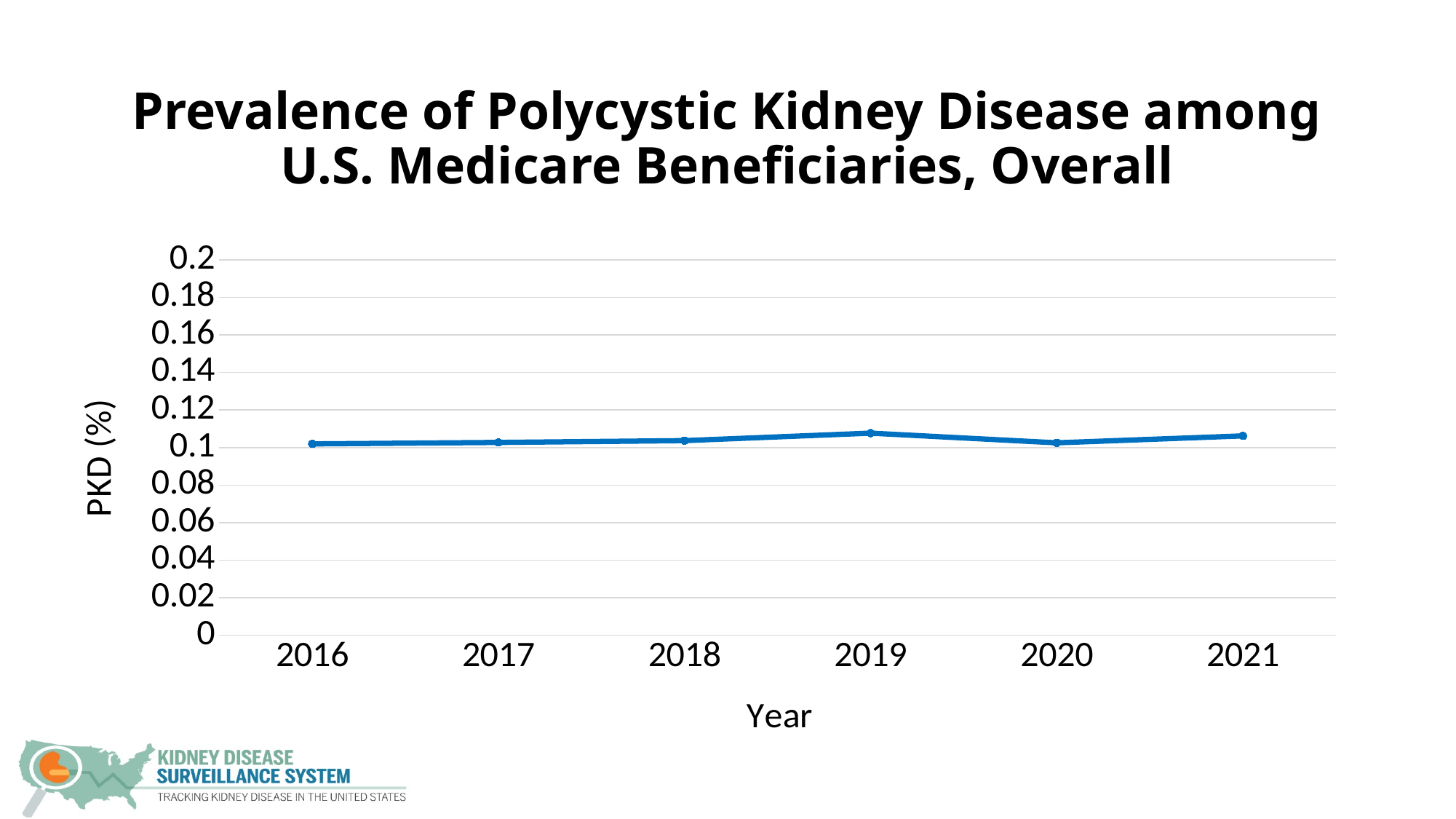
What kind of chart is shown on the slide? line chart Which year has the higher PKD prevalence, 2016 or 2019? 2019 Which year has the higher PKD prevalence, 2020 or 2021? 2021 Is the PKD prevalence for 2019 greater or less than 0.1? greater Is the PKD prevalence for 2017 greater or less than 0.08? greater Is the PKD prevalence for 2019 greater or less than 0.12? less What is the label of the y axis? PKD (%) Which year has the highest PKD prevalence? 2019 What is the title of the chart? Prevalence of Polycystic Kidney Disease among U.S. Medicare Beneficiaries, Overall How many years are plotted on the x axis? 6